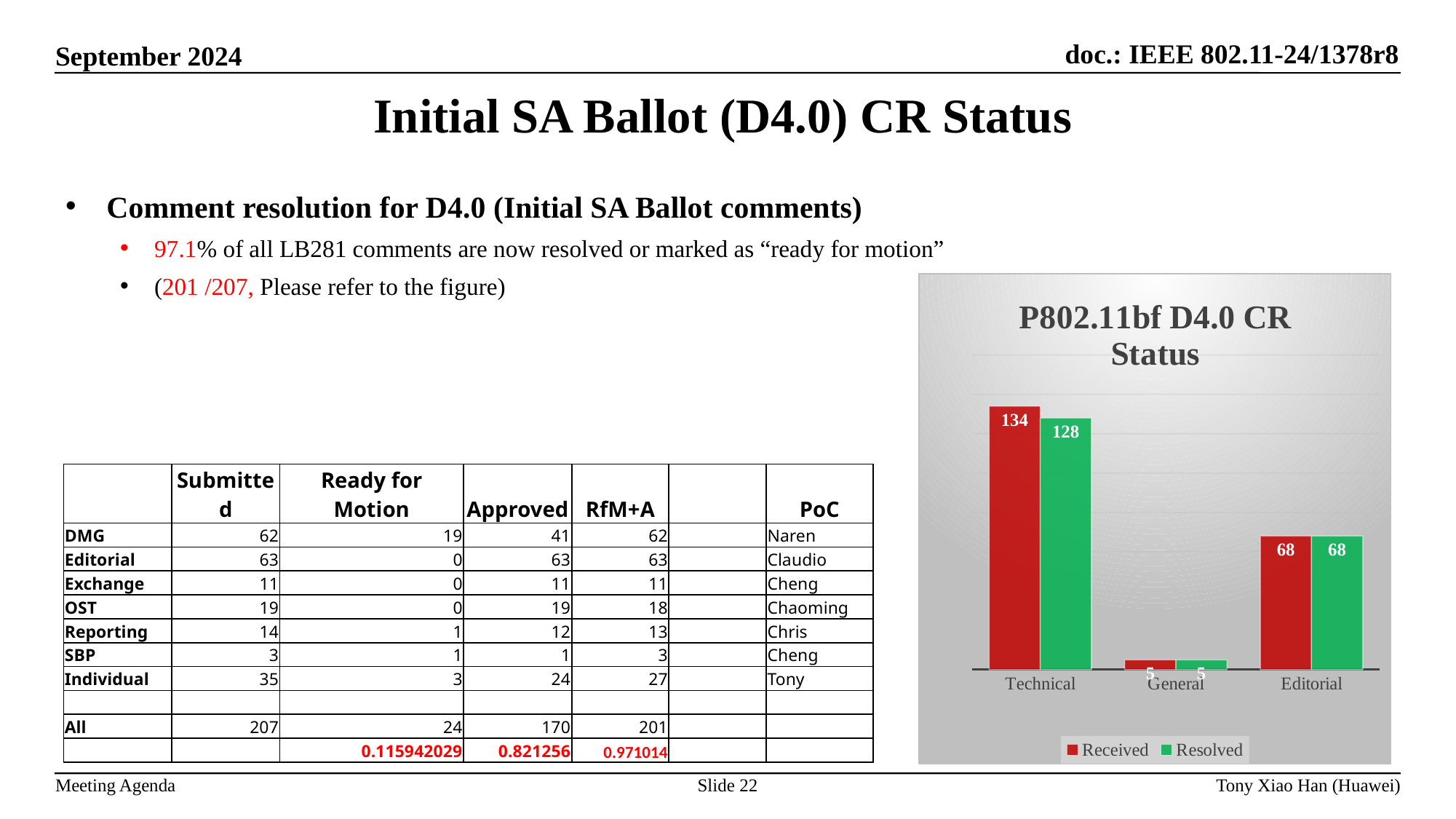
What is the Received value for Technical? 134 What is the Received value for Editorial? 68 What kind of chart is shown on the slide? bar chart What is the Resolved value for General? 5 Which category has the highest Received value? Technical What is the Resolved value for Technical? 128 Which category has the lowest Resolved value? General How many categories are shown on the x axis of the chart? 3 What is the difference between the Received and Resolved values for Technical? 6 Which is larger, the Received value for Editorial or the Received value for General? Editorial What is the title of the chart? P802.11bf D4.0 CR Status How many series does the chart legend list? 2